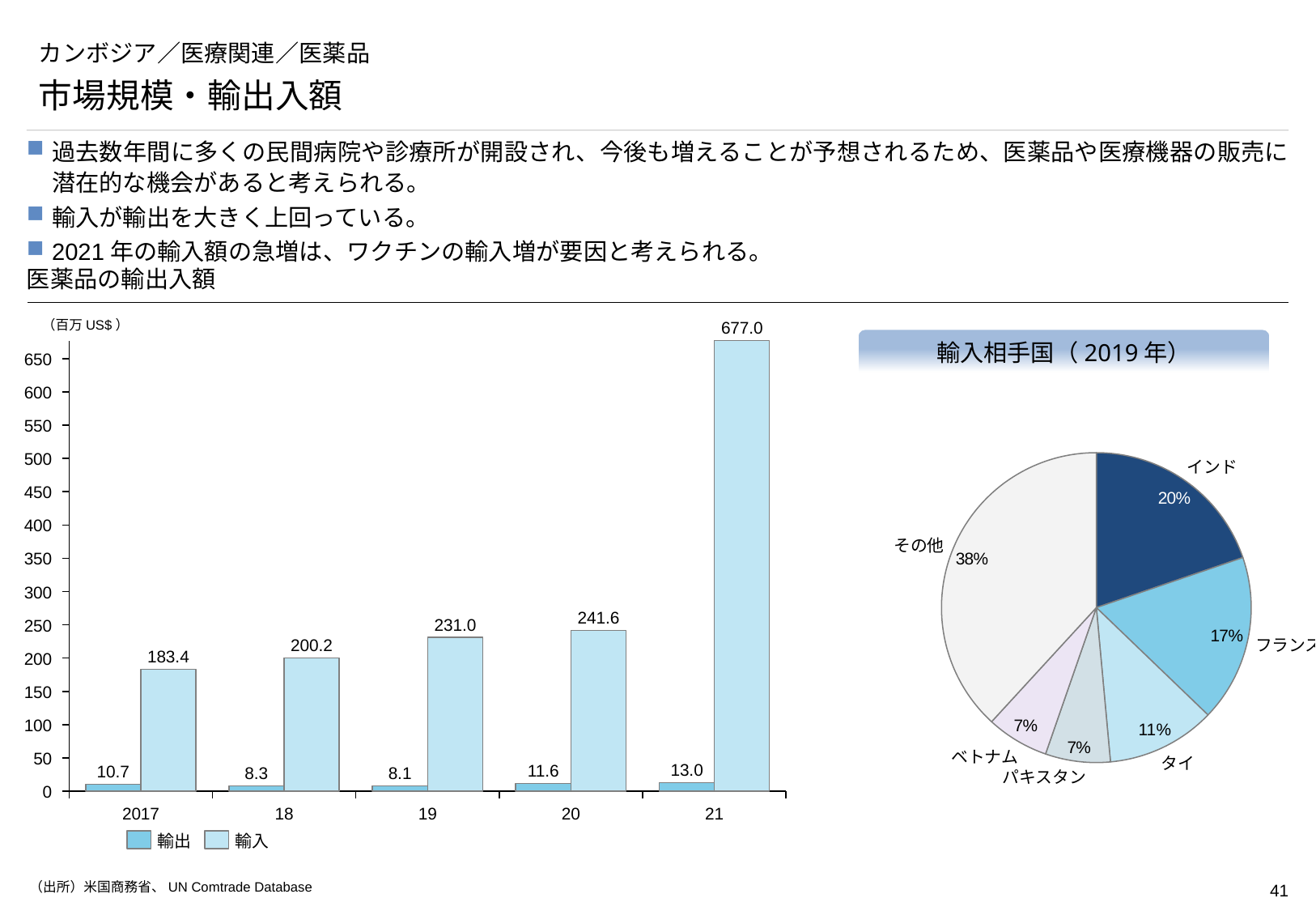
In the bar chart 医薬品の輸出入額, what is the difference between the 輸入 values for 21 and 20? 435.4 What kind of chart is the chart on the right of the slide, 輸入相手国（2019年）? pie chart In the bar chart 医薬品の輸出入額, which is larger, the 輸出 value for 2017 or for 18? 2017 In the bar chart 医薬品の輸出入額, what is the 輸出 value for 21? 13.0 In the pie chart 輸入相手国（2019年）, which named country has the largest share? インド In the bar chart 医薬品の輸出入額, do the 輸入 values rise or fall from 2017 to 21? rise In the bar chart 医薬品の輸出入額, what is the 輸入 value for 2017? 183.4 In the bar chart 医薬品の輸出入額, which year has the lowest 輸出 value? 19 In the bar chart 医薬品の輸出入額, how many years are shown on the x axis? 5 In the bar chart 医薬品の輸出入額, which year has the highest 輸入 value? 21 In the pie chart 輸入相手国（2019年）, what share does インド have? 20% In the bar chart 医薬品の輸出入額, how many series does the legend list? 2